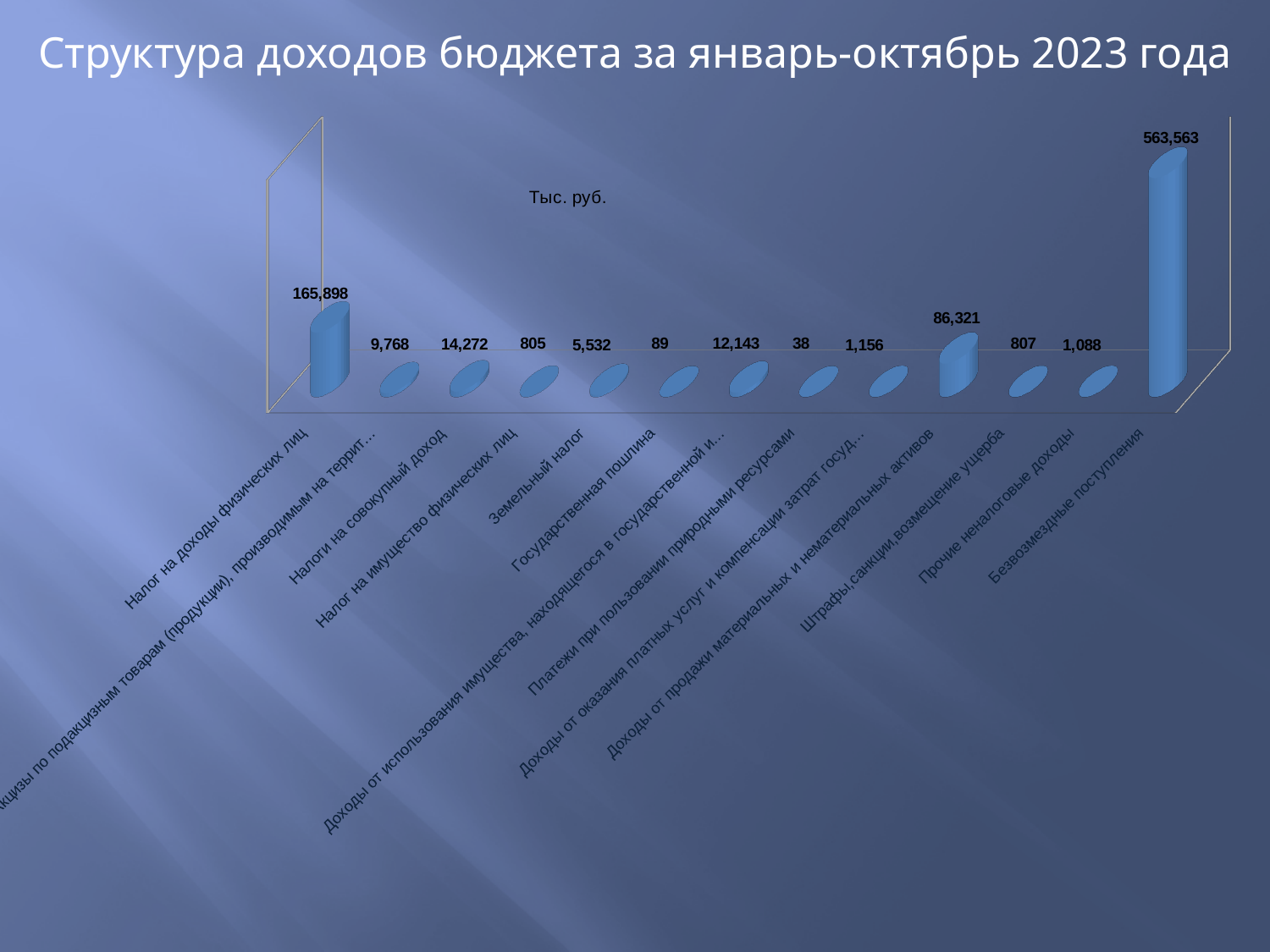
What is the value for Земельный налог? 5,532 What is the value for Безвозмездные поступления? 563,563 Which category has the highest value? Безвозмездные поступления What unit is indicated on the chart? Тыс. руб. What is the difference between Безвозмездные поступления and Налог на доходы физических лиц? 397,665 Which is larger: Налоги на совокупный доход or Земельный налог? Налоги на совокупный доход What is the value for Налог на доходы физических лиц? 165,898 What is the value for Прочие неналоговые доходы? 1,088 What kind of chart is shown on the slide? Bar chart Which category has the lowest value? Платежи при пользовании природными ресурсами What is the value for Государственная пошлина? 89 How many categories are shown in the chart? 13